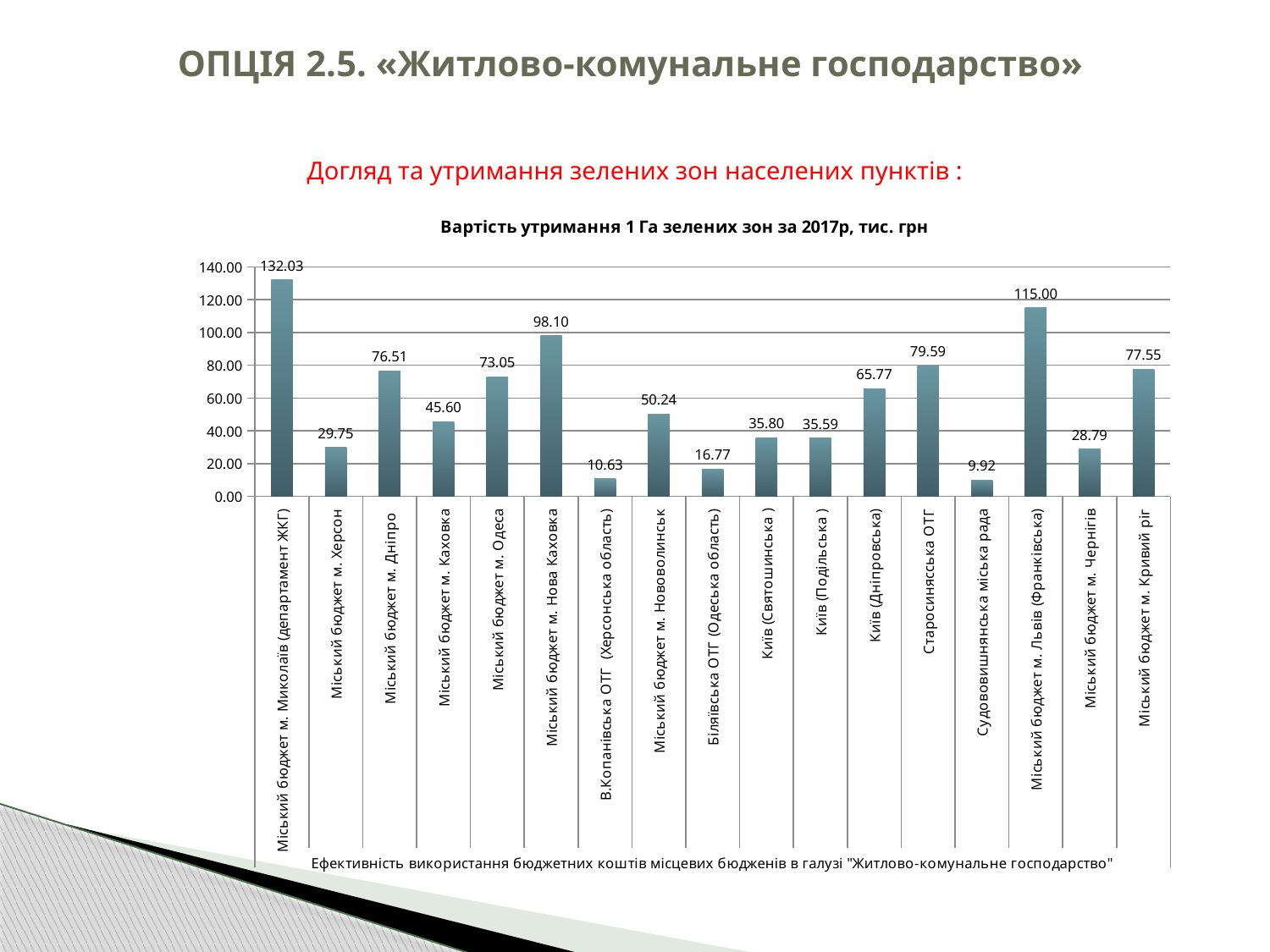
How many categories are shown on the x axis? 17 What is the difference between the values for Міський бюджет м. Миколаїв (департамент ЖКГ) and Міський бюджет м. Львів (Франківська)? 17.03 What is the difference between the values for Міський бюджет м. Нова Каховка and Міський бюджет м. Каховка? 52.50 What is the value for Міський бюджет м. Нова Каховка? 98.10 What is the value for Біляївська ОТГ (Одеська область)? 16.77 What is the title of the chart? Вартість утримання 1 Га зелених зон за 2017р, тис. грн Which is larger, the value for Міський бюджет м. Дніпро or Міський бюджет м. Одеса? Міський бюджет м. Дніпро What is the value for Міський бюджет м. Миколаїв (департамент ЖКГ)? 132.03 Which category has the highest value? Міський бюджет м. Миколаїв (департамент ЖКГ) What is the value for Київ (Дніпровська)? 65.77 Which category has the lowest value? Судововишнянська міська рада What type of chart is shown on the slide? bar chart